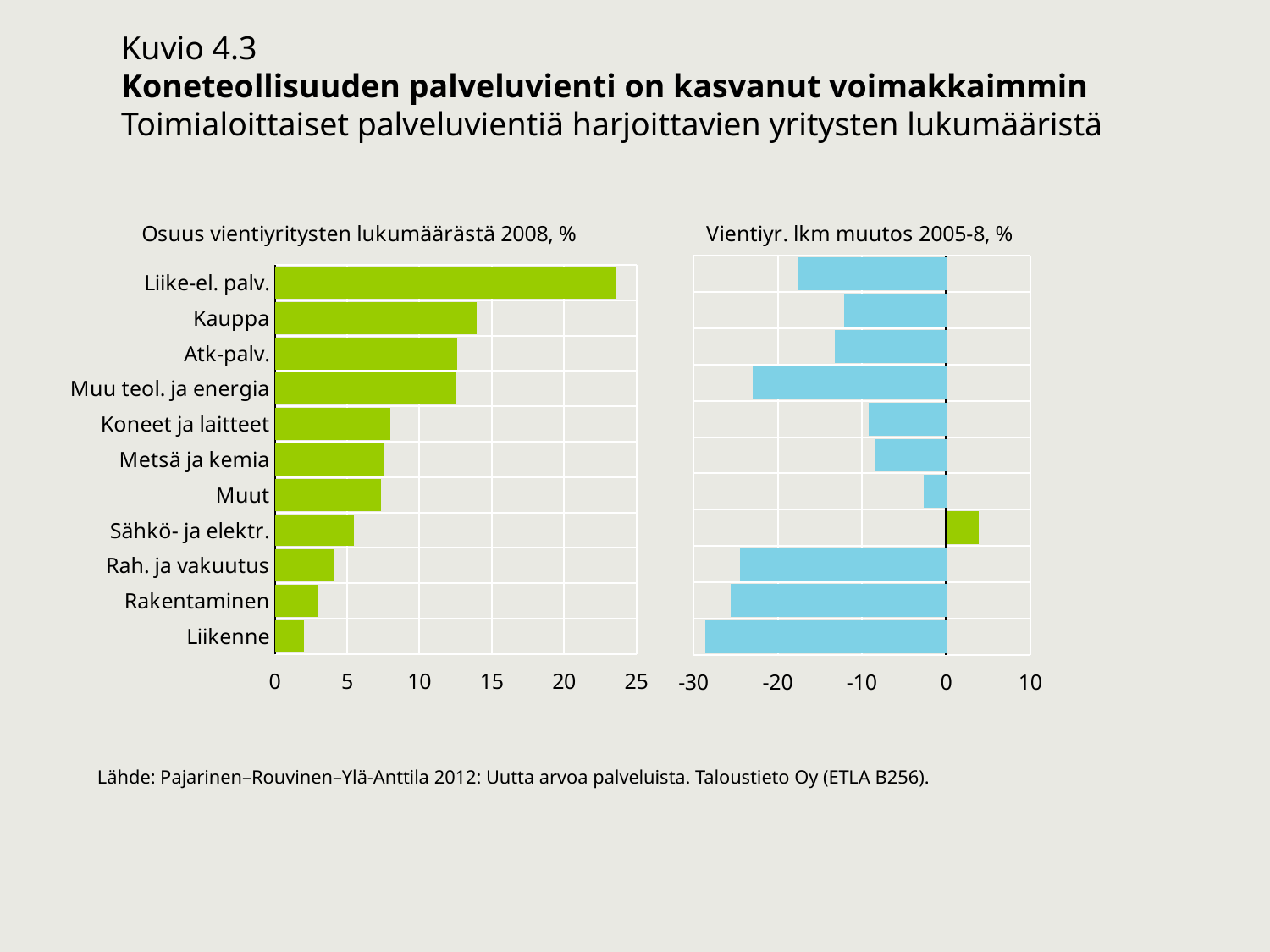
In the left chart 'Osuus vientiyritysten lukumäärästä 2008, %', is the value for Liike-el. palv. greater or less than 20? greater In the left chart 'Osuus vientiyritysten lukumäärästä 2008, %', which category has the lowest value? Liikenne How many categories are shown in the left chart 'Osuus vientiyritysten lukumäärästä 2008, %'? 11 In the left chart 'Osuus vientiyritysten lukumäärästä 2008, %', which is larger: Kauppa or Koneet ja laitteet? Kauppa In the right chart 'Vientiyr. lkm muutos 2005-8, %', is the value for Muu teol. ja energia greater or less than -20? less What kind of chart is the left chart titled 'Osuus vientiyritysten lukumäärästä 2008, %'? bar chart In the left chart 'Osuus vientiyritysten lukumäärästä 2008, %', is the value for Kauppa greater or less than 10? greater What is the title of the right chart? Vientiyr. lkm muutos 2005-8, % In the right chart 'Vientiyr. lkm muutos 2005-8, %', which category has the highest value? Sähkö- ja elektr. In the left chart 'Osuus vientiyritysten lukumäärästä 2008, %', which category has the highest value? Liike-el. palv.